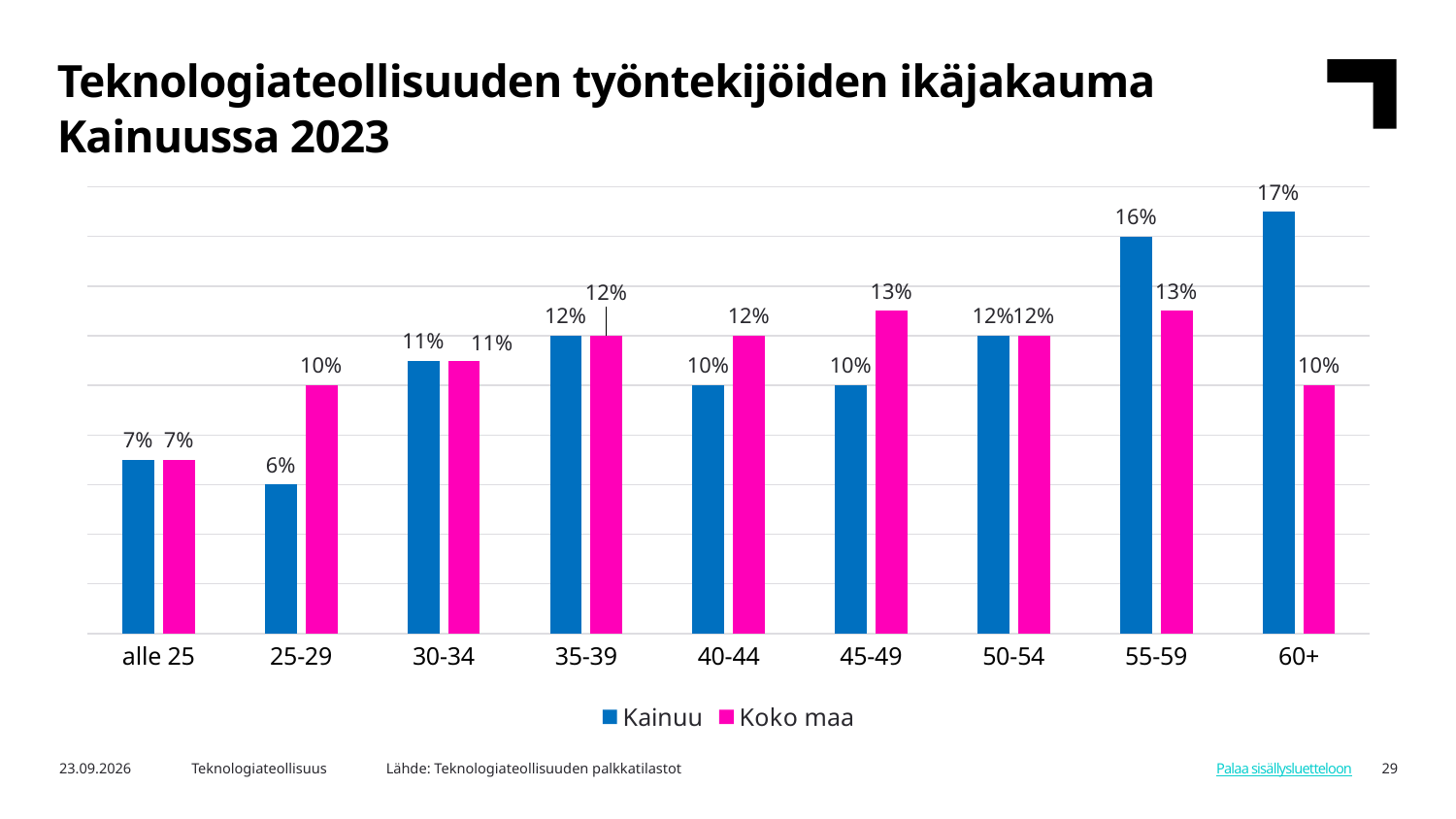
What is the value for Koko maa in the 45-49 age group? 13% In the 25-29 age group, which series has the larger value, Kainuu or Koko maa? Koko maa Which age group has the lowest value for Kainuu? 25-29 How many series does the legend list? 2 What is the value for Kainuu in the 60+ age group? 17% Which colour represents the Koko maa series? Pink Which age group has the highest value for Kainuu? 60+ What kind of chart is shown on the slide? Bar chart What is the difference between the Kainuu and Koko maa values in the 60+ age group? 7 percentage points In the 55-59 age group, which series has the larger value, Kainuu or Koko maa? Kainuu How many age groups are shown on the x axis? 9 What is the value for Kainuu in the 25-29 age group? 6%